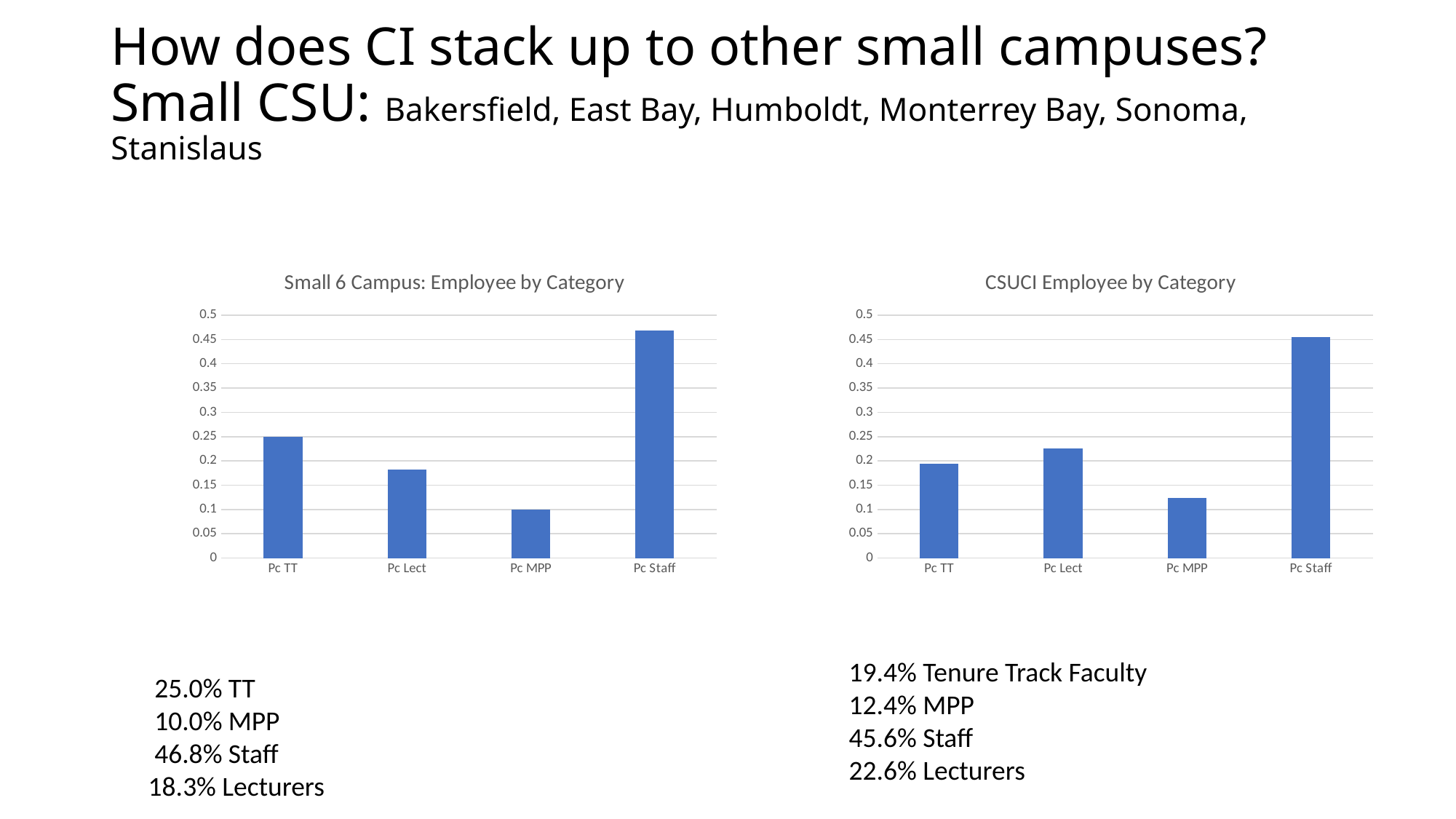
In the 'Small 6 Campus: Employee by Category' chart, is the value for Pc Staff greater or less than 0.4? greater In the 'CSUCI Employee by Category' chart, which is larger, Pc Lect or Pc TT? Pc Lect In the 'Small 6 Campus: Employee by Category' chart, which category has the lowest value? Pc MPP What kind of chart is the 'Small 6 Campus: Employee by Category' chart? bar chart In the 'Small 6 Campus: Employee by Category' chart, which category has the highest value? Pc Staff In the 'CSUCI Employee by Category' chart, is the value for Pc Lect greater or less than 0.2? greater In the 'CSUCI Employee by Category' chart, which category has the lowest value? Pc MPP In the 'CSUCI Employee by Category' chart, which category has the highest value? Pc Staff In the 'Small 6 Campus: Employee by Category' chart, how many categories are shown on the x axis? 4 What is the title of the chart on the right side of the slide? CSUCI Employee by Category In the 'Small 6 Campus: Employee by Category' chart, what is the value for Pc TT? 0.25 In the 'Small 6 Campus: Employee by Category' chart, what is the value for Pc MPP? 0.1